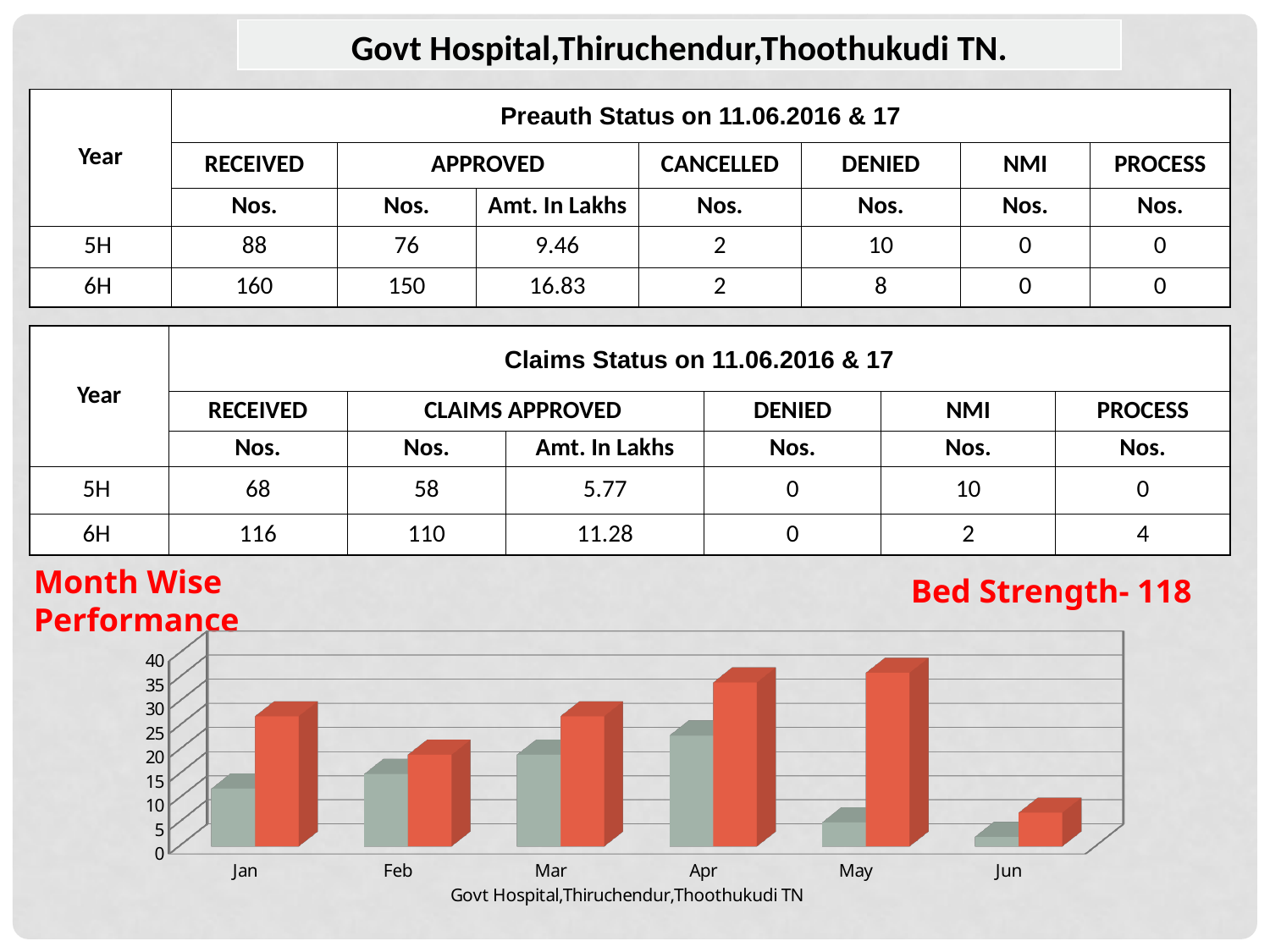
In the Month Wise Performance chart, is the red bar for Jan greater or less than 20? greater In the Month Wise Performance chart, is the red bar for Jun greater or less than 10? less In the Month Wise Performance chart, is the grey bar for May greater or less than 10? less In the Month Wise Performance chart, which month has the lowest red bar? Jun What kind of chart is shown at the bottom of the slide? bar chart What text appears below the x axis of the Month Wise Performance chart? Govt Hospital,Thiruchendur,Thoothukudi TN In the Month Wise Performance chart, which month has the highest grey bar? Apr In the Month Wise Performance chart, which month has the lowest grey bar? Jun How many months are shown on the x axis of the Month Wise Performance chart? 6 In the Month Wise Performance chart, do the grey bars rise or fall from Apr to Jun? fall In the Month Wise Performance chart, which is larger for Jan, the grey bar or the red bar? the red bar